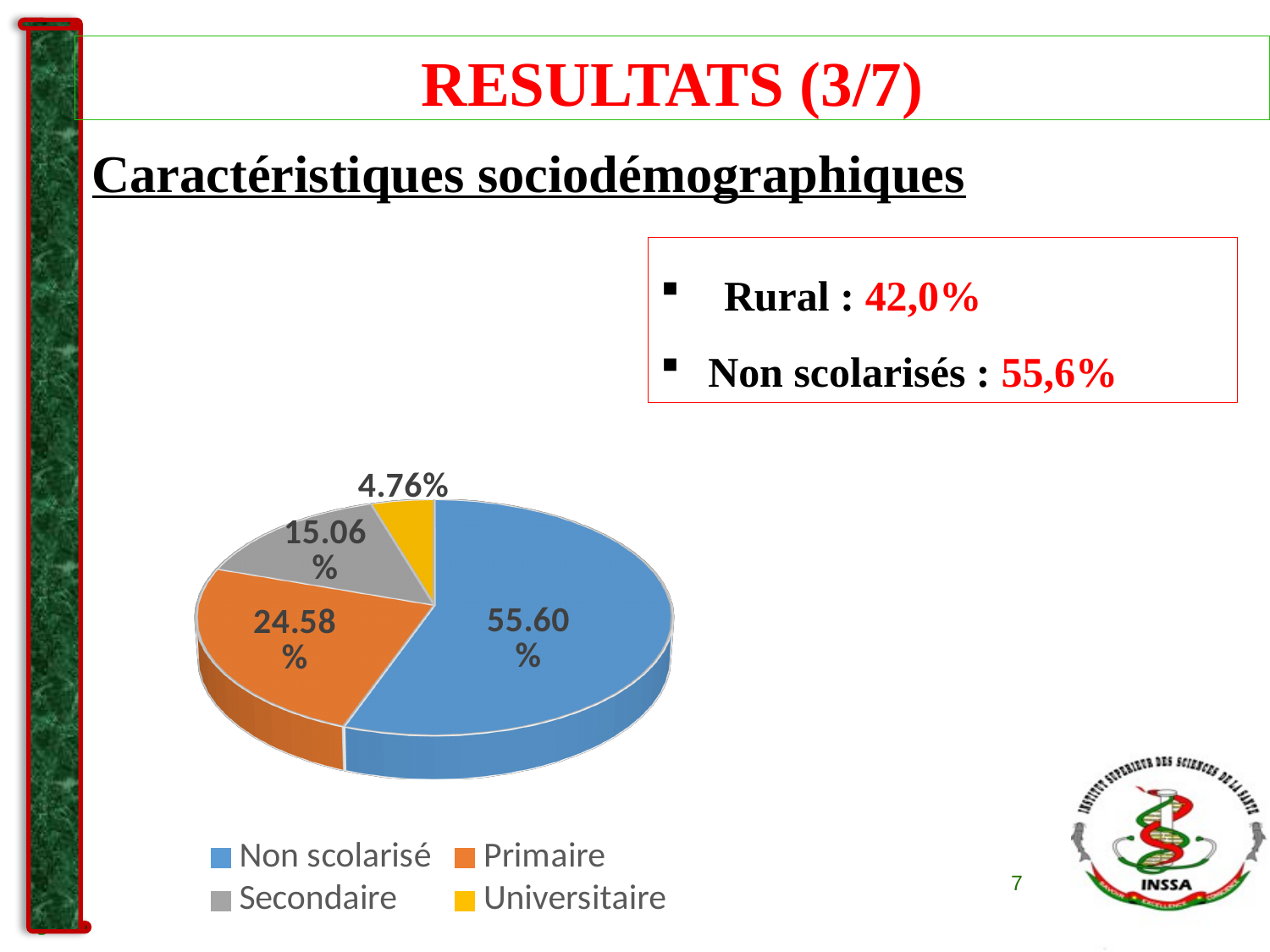
What is the value for Non scolarisé in the pie chart? 55.60% How many slices does the pie chart have? 4 What colour is the Primaire slice in the pie chart? orange Which is larger in the pie chart, Secondaire or Universitaire? Secondaire Which category has the largest slice of the pie chart? Non scolarisé What is the value for Secondaire in the pie chart? 15.06% How many entries does the legend of the pie chart list? 4 What is the difference between the Non scolarisé and Primaire values in the pie chart? 31.02% What kind of chart is shown on the slide? pie chart What is the value for Universitaire in the pie chart? 4.76% Which category has the smallest slice of the pie chart? Universitaire What is the value for Primaire in the pie chart? 24.58%